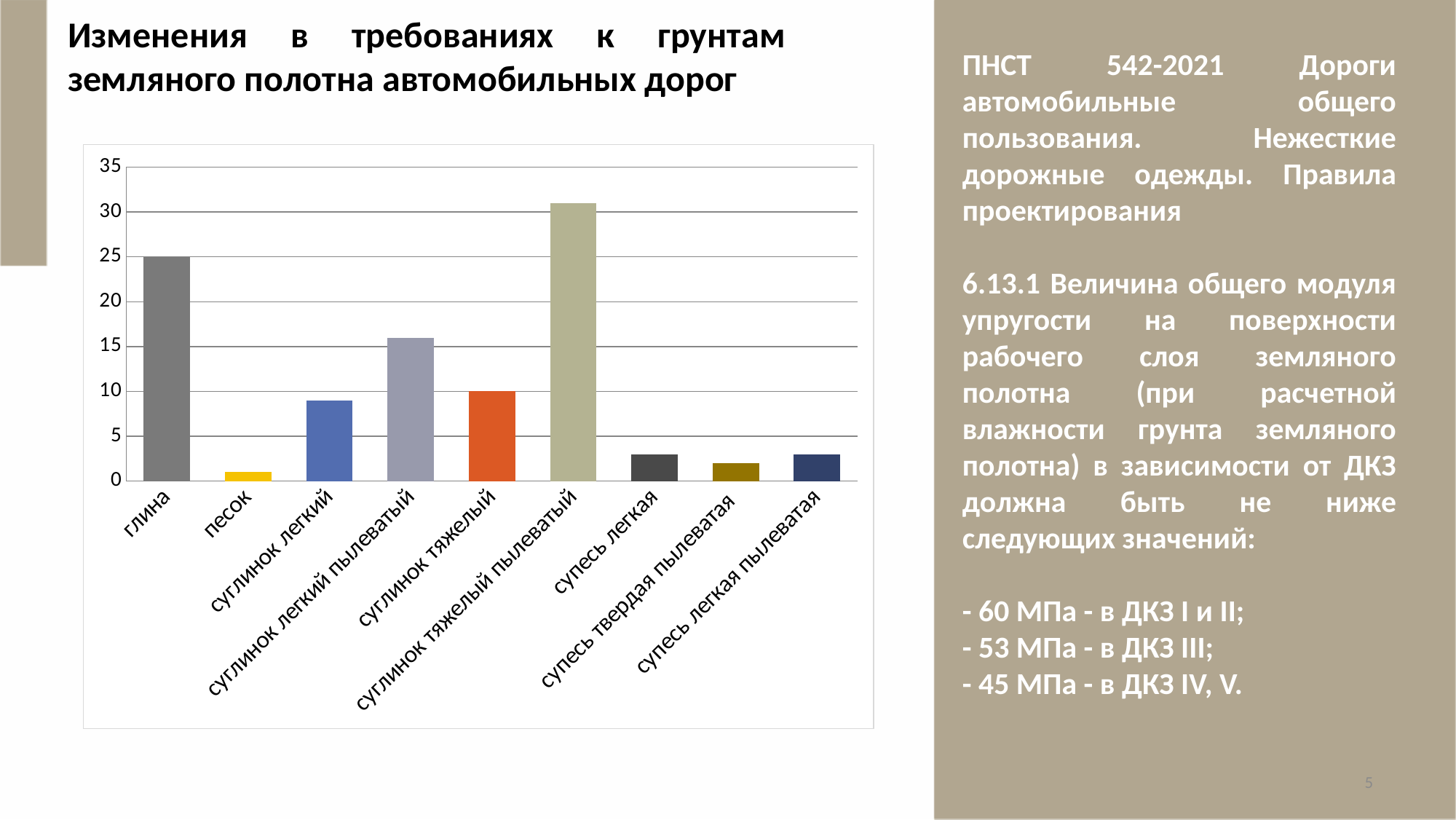
Which category has the lowest bar in the chart? песок How many soil categories are shown on the x axis of the chart? 9 What kind of chart is shown on the slide? bar chart Which is larger, the value for глина or the value for суглинок легкий пылеватый? глина Which category has the highest bar in the chart? суглинок тяжелый пылеватый What is the value for глина in the chart? 25 Is the value for супесь твердая пылеватая greater or less than 5? less Is the value for суглинок легкий пылеватый greater or less than 15? greater What is the highest value shown on the vertical axis of the chart? 35 Is the value for суглинок легкий greater or less than 10? less What is the value for суглинок тяжелый in the chart? 10